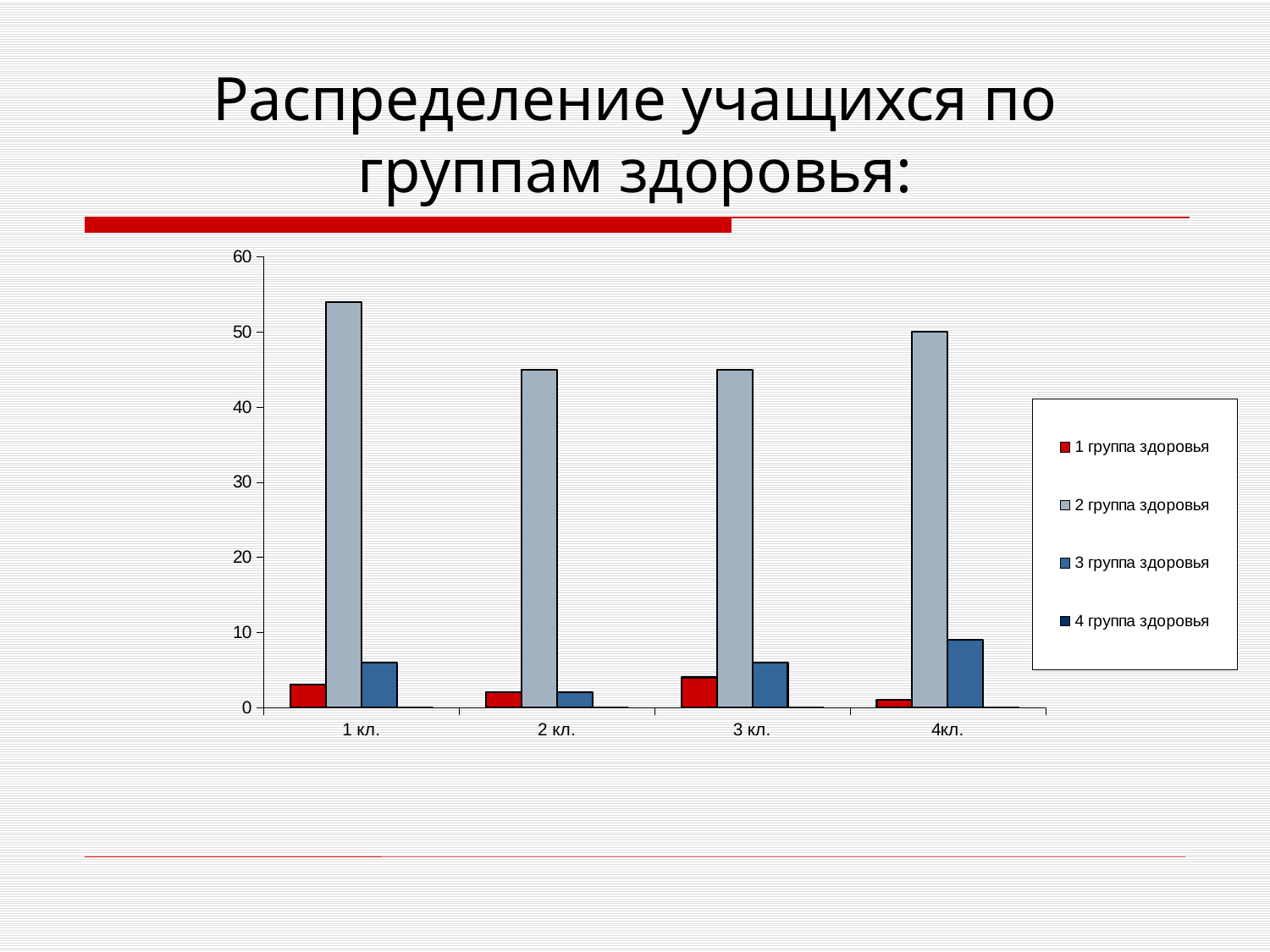
Is the value for 2 группа здоровья in 1 кл. greater or less than 50? greater Which is larger: the value for 2 группа здоровья in 1 кл. or in 4кл.? 1 кл. Which class has the lowest value for 3 группа здоровья? 2 кл. How many series does the legend list? 4 What kind of chart is shown on the slide? bar chart Is the value for 2 группа здоровья in 2 кл. greater or less than 40? greater Which class has the highest value for 3 группа здоровья? 4кл. Is the value for 3 группа здоровья in 4кл. greater or less than 10? less Which is larger: the value for 3 группа здоровья in 3 кл. or in 2 кл.? 3 кл. How many classes (categories) are shown on the x axis? 4 What is the title of the slide containing the chart? Распределение учащихся по группам здоровья: Which class has the highest value for 2 группа здоровья? 1 кл.